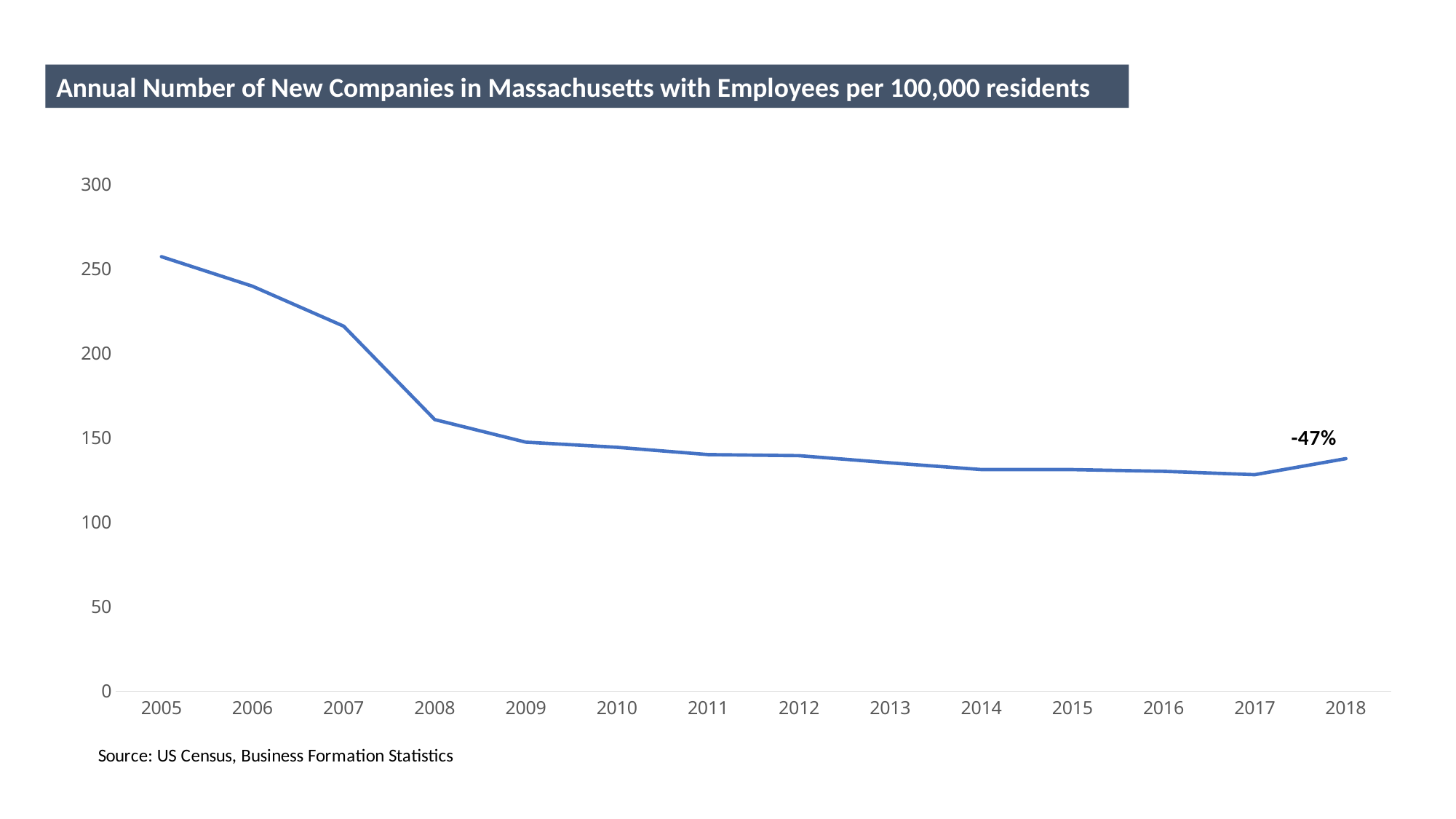
Which year has the larger value, 2005 or 2018? 2005 Is the value for 2008 greater or less than 150? greater Which year has the highest value on the chart? 2005 What percentage change is annotated at the end of the line near 2018? -47% Do the values generally rise or fall from 2005 to 2018? fall What kind of chart is shown on the slide? line chart Which year has the larger value, 2007 or 2009? 2007 Is the value for 2005 greater or less than 200? greater Is the value for 2017 greater or less than 150? less How many years are plotted along the x axis? 14 What is the title of the chart? Annual Number of New Companies in Massachusetts with Employees per 100,000 residents